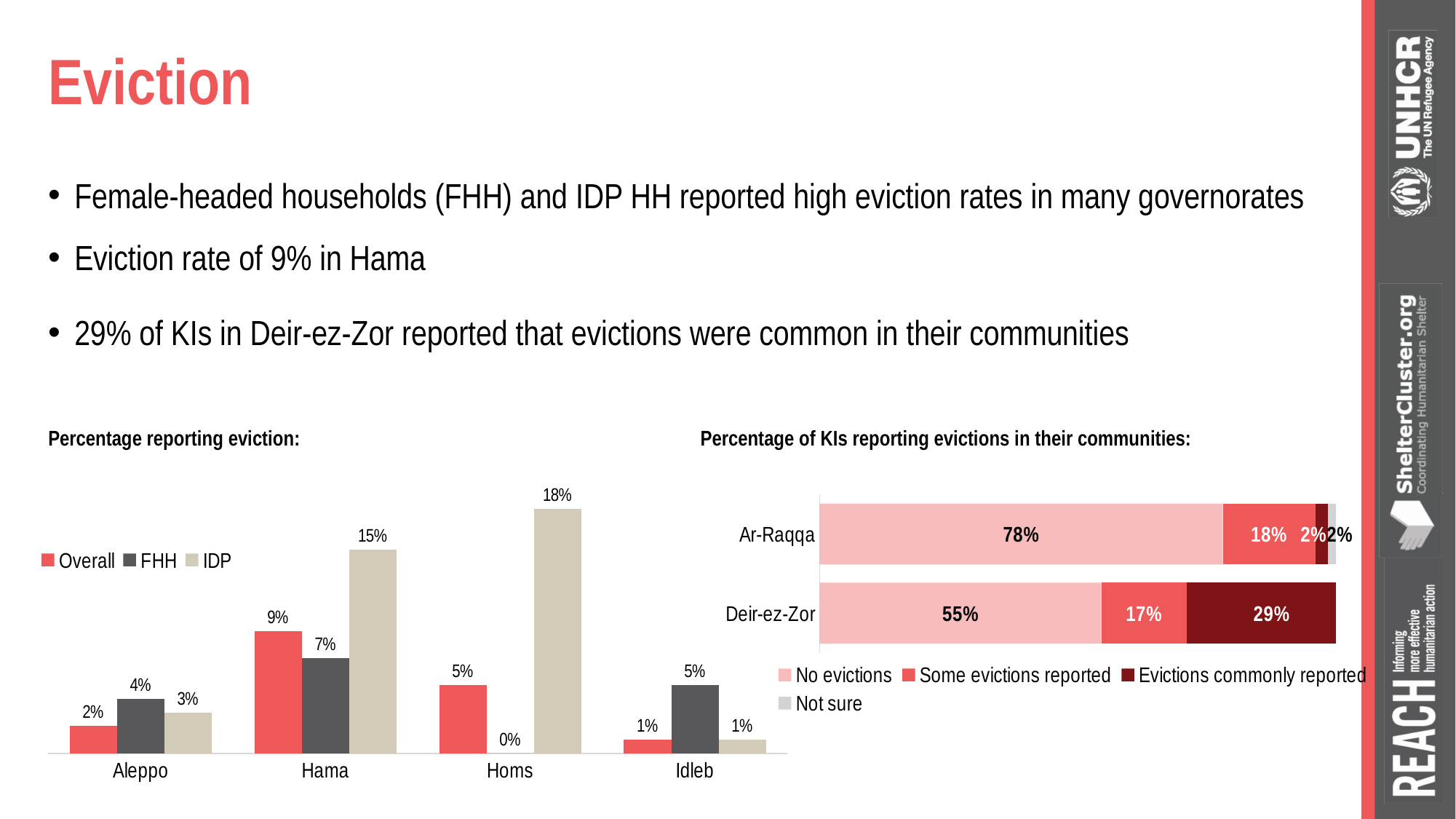
In the 'Percentage reporting eviction' chart, which governorate has the highest IDP value? Homs In the 'Percentage reporting eviction' chart, which governorate has the lowest Overall value? Idleb In the 'Percentage reporting eviction' chart, what is the Overall value for Hama? 9% What kind of chart is the 'Percentage of KIs reporting evictions in their communities' chart? Stacked horizontal bar chart In the 'Percentage reporting eviction' chart, what is the difference between the IDP and FHH values for Hama? 8% In the 'Percentage reporting eviction' chart, which is larger for Aleppo: the FHH value or the IDP value? FHH In the 'Percentage reporting eviction' chart, what is the IDP value for Homs? 18% How many governorates are shown on the x axis of the 'Percentage reporting eviction' chart? 4 How many series does the legend of the 'Percentage reporting eviction' chart list? 3 In the 'Percentage reporting eviction' chart, what is the FHH value for Idleb? 5% In the 'Percentage of KIs reporting evictions in their communities' chart, what is the difference between the 'No evictions' values for Ar-Raqqa and Deir-ez-Zor? 23% In the 'Percentage of KIs reporting evictions in their communities' chart, what share of KIs in Deir-ez-Zor reported that evictions were commonly reported? 29%